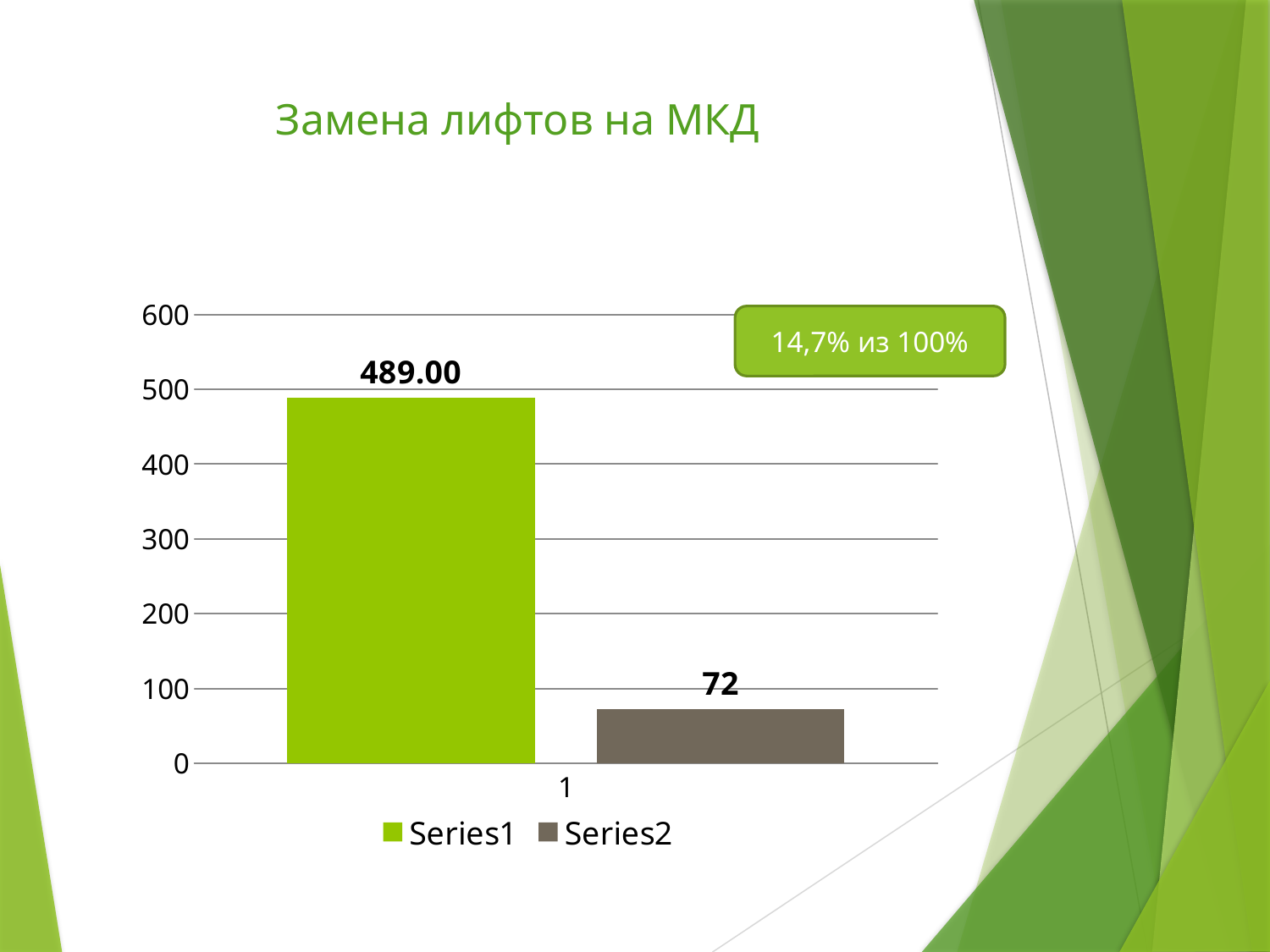
What kind of chart is shown on the slide? bar chart Which series has the higher value? Series1 Which series has the lower value? Series2 What text is shown in the green callout box next to the chart? 14,7% из 100% Is the value for Series2 greater or less than 100? less Is the value for Series1 larger or smaller than the value for Series2? larger What is the difference between the Series1 value and the Series2 value? 417 What is the value for Series1? 489.00 What is the title of the slide? Замена лифтов на МКД What is the value for Series2? 72 How many series does the legend list? 2 Is the value for Series1 greater or less than 400? greater